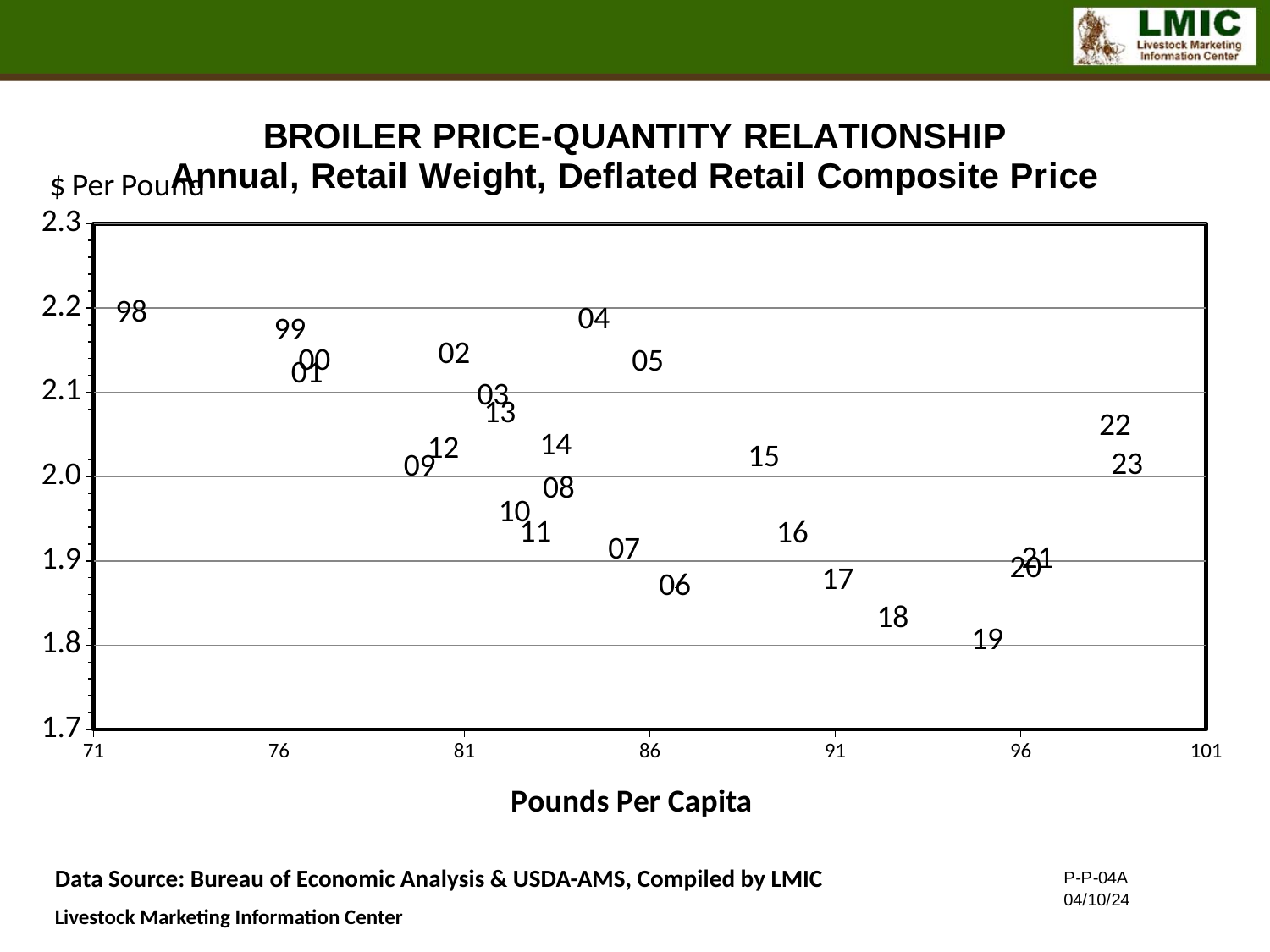
Is the pounds per capita value for the point labeled 98 greater or less than 76? less Is the price value for the point labeled 98 greater or less than 2.1? greater Is the price value for the point labeled 22 greater or less than 2.0? greater Which labeled point has the lowest pounds per capita? 98 What unit is shown for the vertical axis? $ Per Pound What kind of chart is shown on the slide? scatter chart Which point has a higher price per pound, 04 or 06? 04 How many data points (years) are plotted on the chart? 26 What is the label of the horizontal axis? Pounds Per Capita Which labeled point has the lowest price per pound? 19